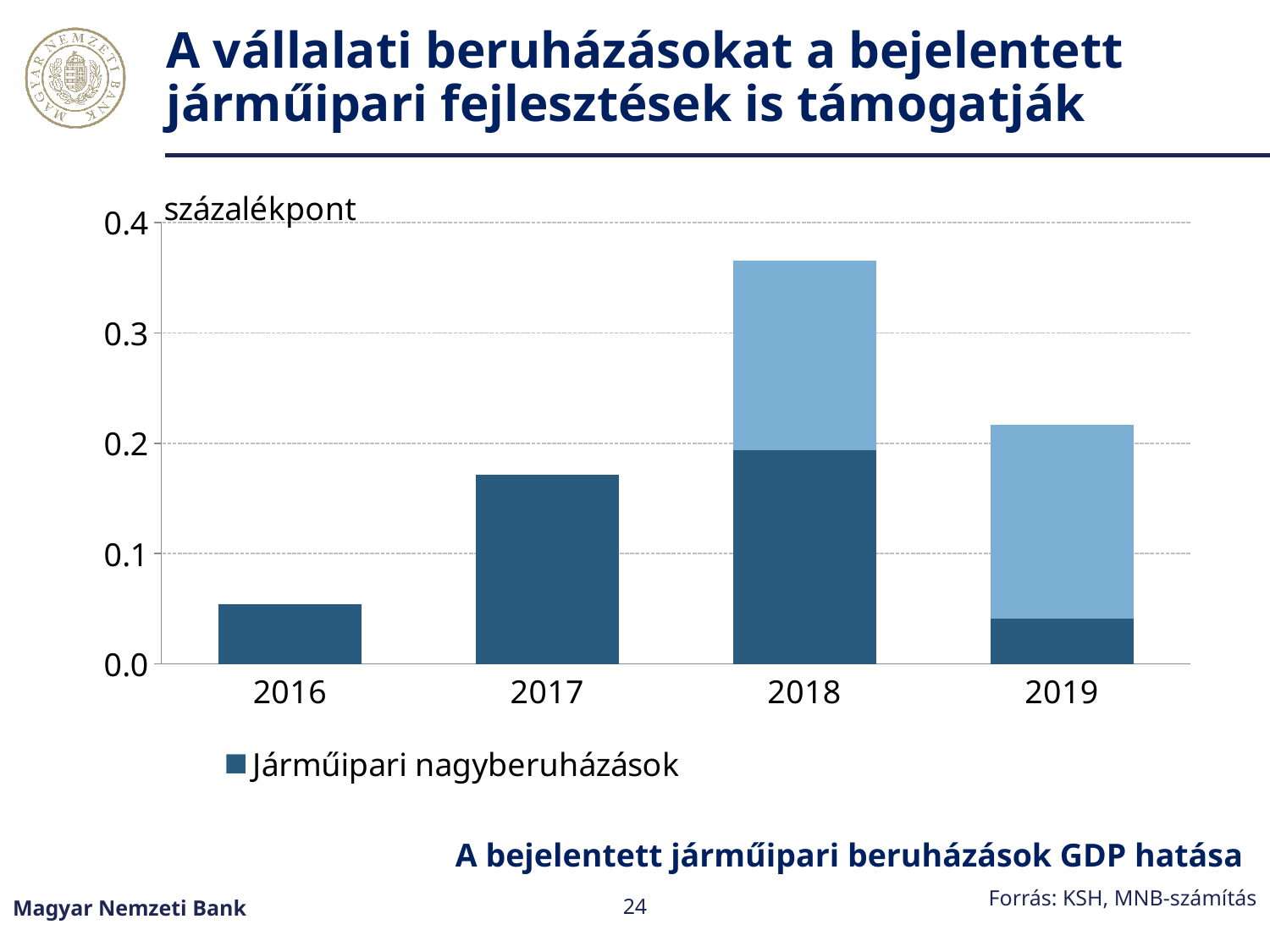
Which year has the larger total bar, 2016 or 2017? 2017 What kind of chart is shown on the slide? bar chart What unit is shown at the top of the chart's vertical axis? százalékpont How many years are shown on the x axis of the chart? 4 Is the bar for 2016 greater or less than 0.1? less Is the bar for 2017 greater or less than 0.2? less Which year has the shortest bar in the chart? 2016 Is the total bar height for 2019 greater or less than 0.2? greater How many series does the chart's legend list? 1 Which year has the larger dark blue (Járműipari nagyberuházások) segment, 2018 or 2019? 2018 Which year has the tallest bar in the chart? 2018